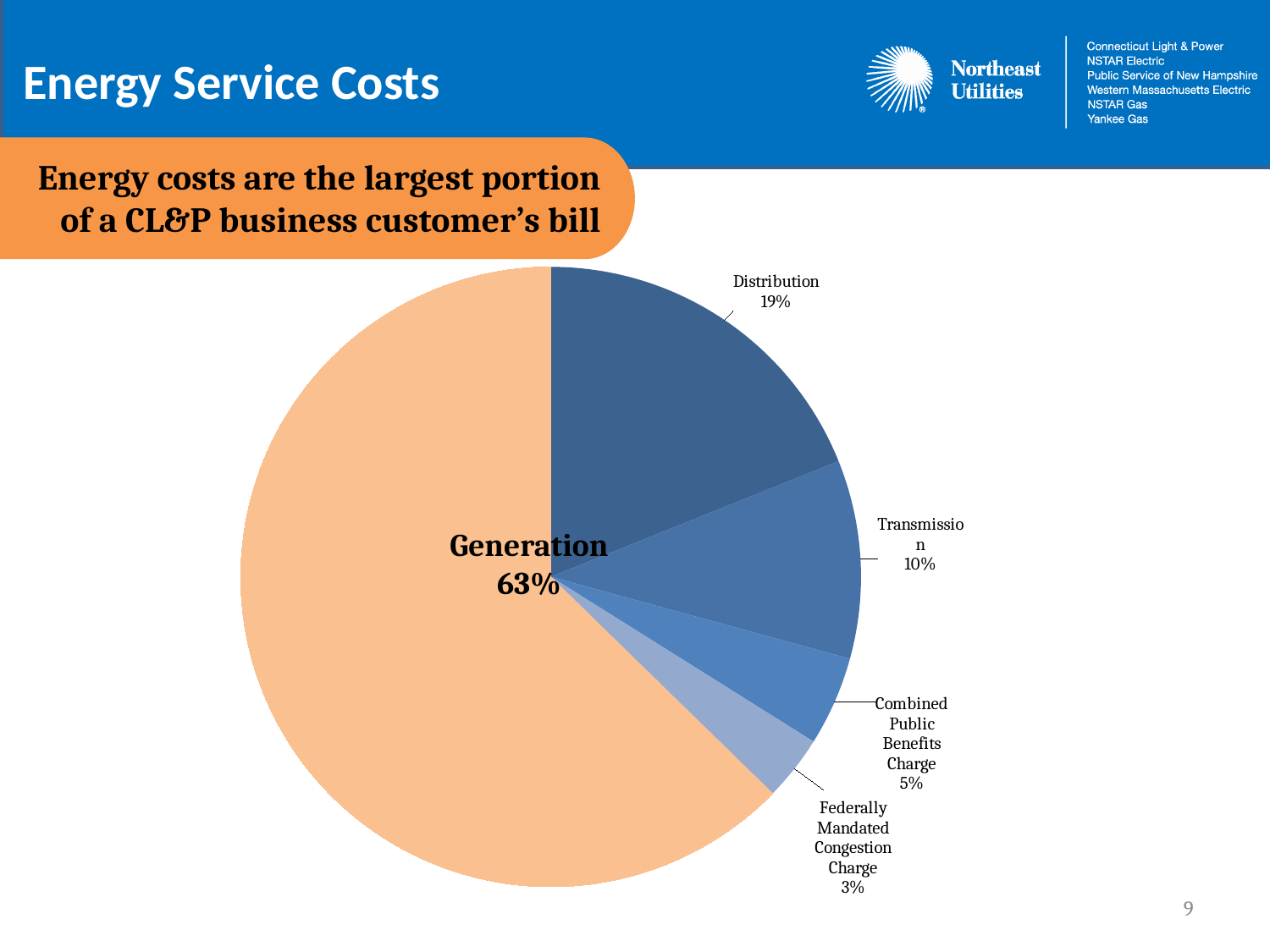
Which is larger, the Combined Public Benefits Charge or the Federally Mandated Congestion Charge? Combined Public Benefits Charge What share of the pie does Generation represent? 63% Which slice of the pie is the smallest? Federally Mandated Congestion Charge What percentage is shown for Transmission? 10% What percentage is shown for the Federally Mandated Congestion Charge? 3% How many slices does the pie chart have? 5 What percentage is shown for the Combined Public Benefits Charge? 5% Which slice of the pie is the largest? Generation What kind of chart is shown on the slide? Pie chart What percentage is shown for Distribution? 19% What is the difference in percentage points between Distribution and Transmission? 9 percentage points What colour is the Generation slice? Light orange